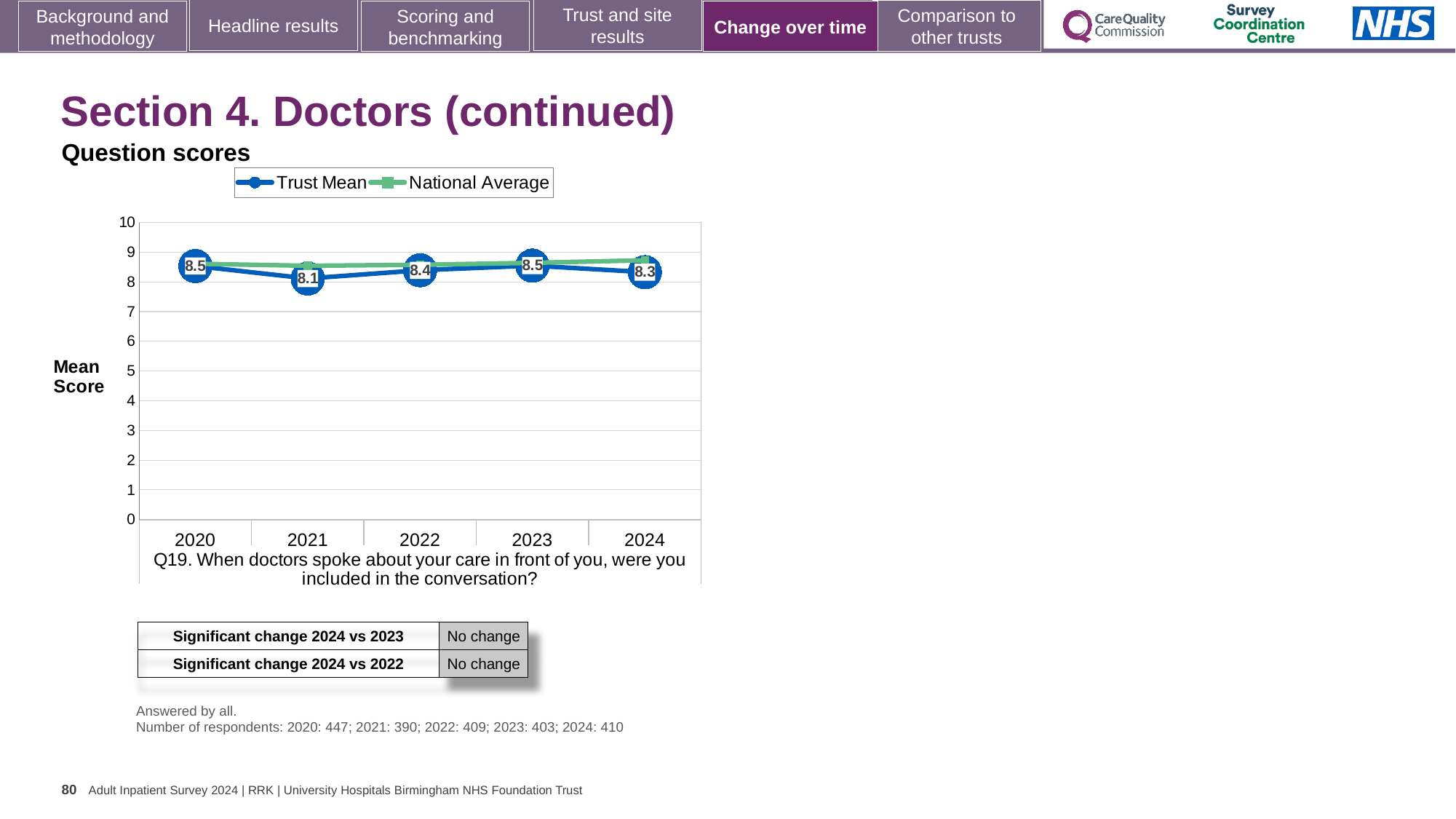
How many years are plotted on the x axis? 5 Is the National Average value for 2024 greater or less than 8? greater What kind of chart is shown on the slide? Line chart Does the Trust Mean score rise or fall from 2021 to 2023? Rise What is the Trust Mean score for 2021? 8.1 Which year has the higher Trust Mean score, 2021 or 2022? 2022 What is the Trust Mean score for 2022? 8.4 What are the two series named in the legend? Trust Mean and National Average What is the difference between the Trust Mean scores for 2020 and 2021? 0.4 What is the Trust Mean score for 2024? 8.3 In which year is the Trust Mean score lowest? 2021 How many series does the legend list? 2